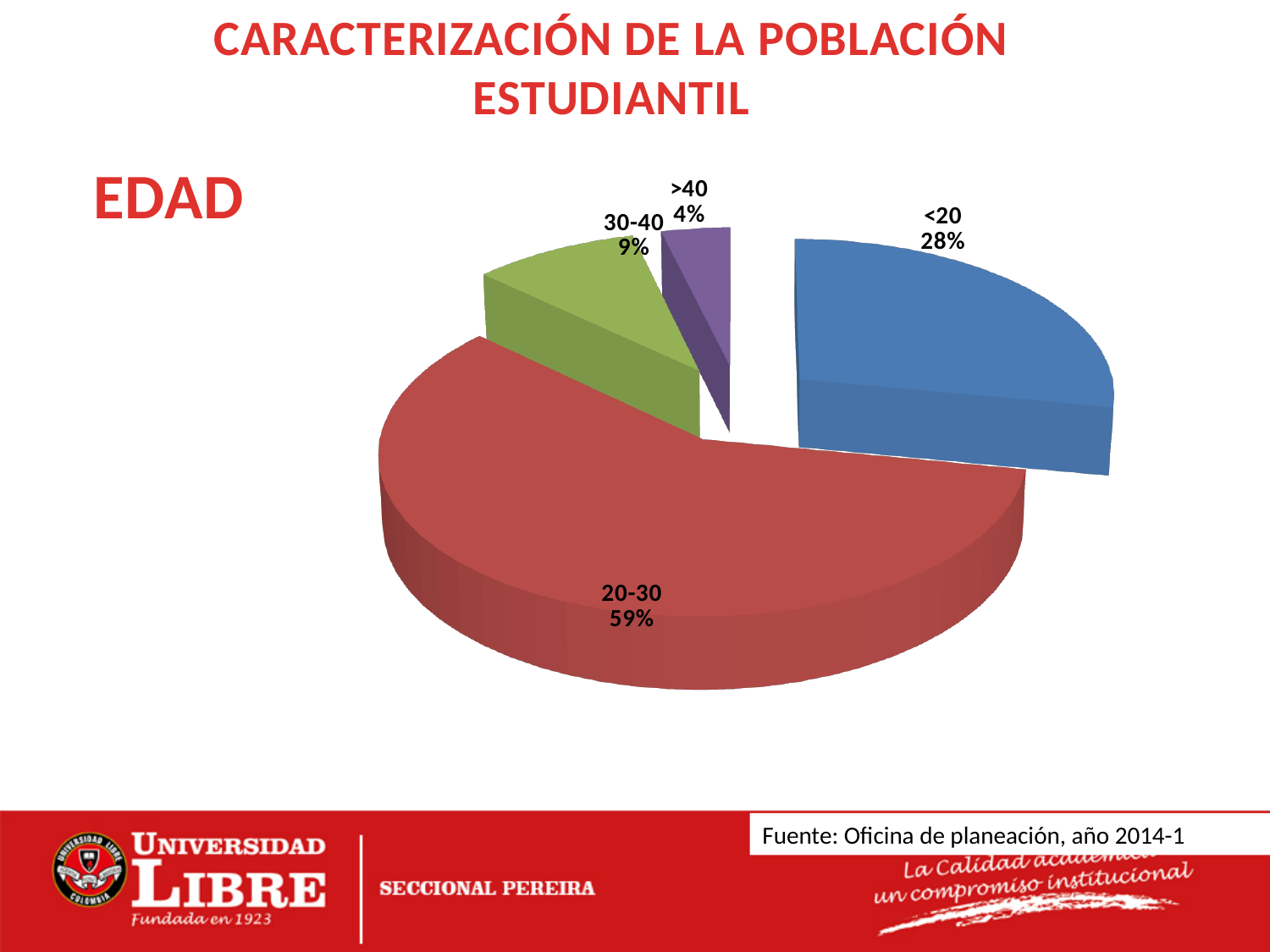
What percentage of the student population is in the 30-40 age group? 9% Which age group has the largest share of the pie? 20-30 What is the difference in percentage points between the 20-30 group and the <20 group? 31 How many age groups (slices) does the pie chart show? 4 What colour is the slice for the 20-30 age group? red What percentage of the student population is in the 20-30 age group? 59% Which is larger, the share for 30-40 or the share for >40? 30-40 What is the heading shown to the left of the pie chart? EDAD Which age group has the smallest share of the pie? >40 What percentage of the student population is under 20 (<20)? 28% What kind of chart is shown on the slide? pie chart What percentage of the student population is over 40 (>40)? 4%